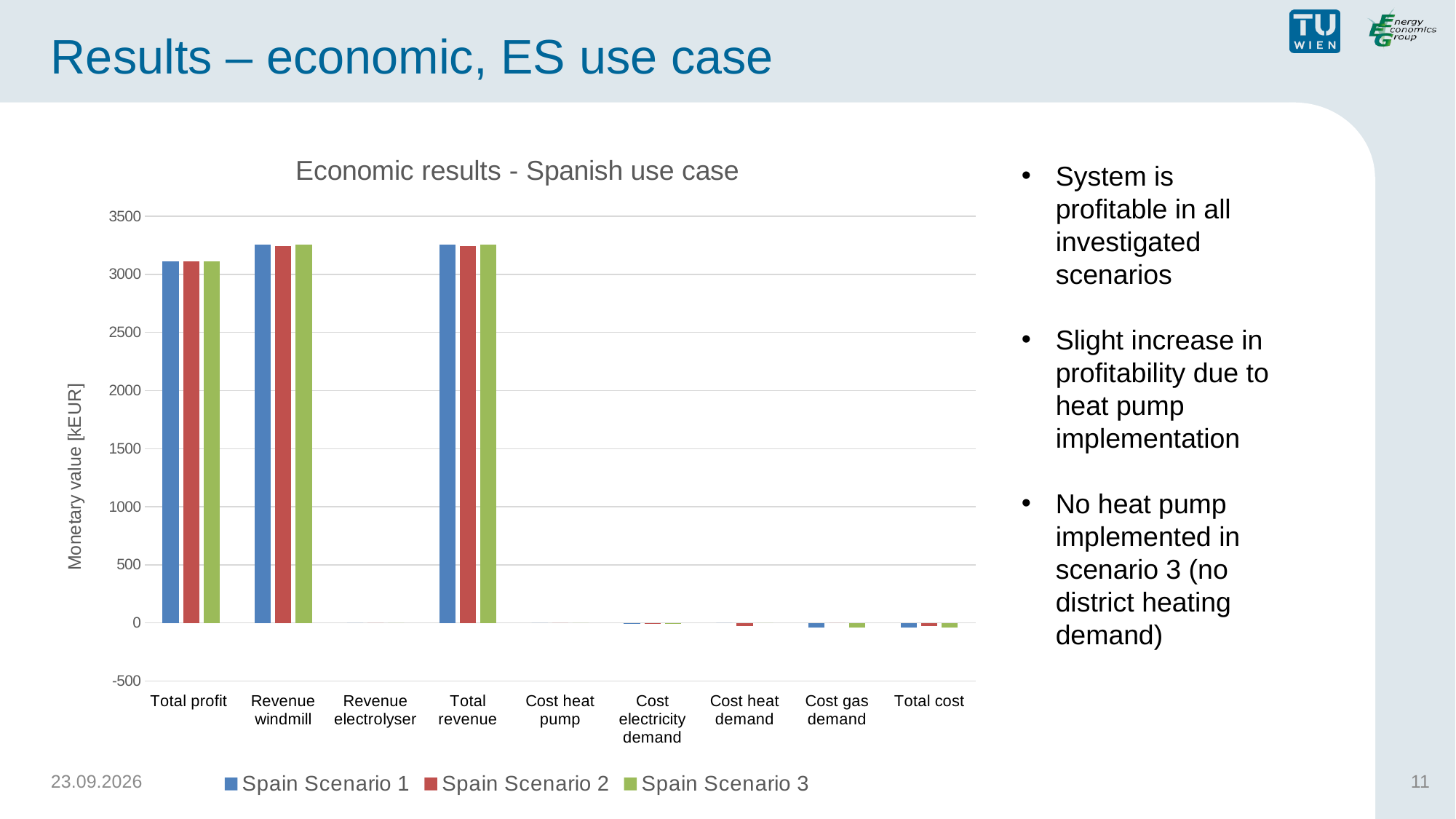
For Spain Scenario 1, which is larger: Total revenue or Total cost? Total revenue Is the value for Total profit in Spain Scenario 1 greater or less than 3000? greater How many categories are shown on the x axis? 9 For Spain Scenario 1, which is larger: Revenue windmill or Total profit? Revenue windmill For Spain Scenario 2, which is larger: Revenue windmill or Revenue electrolyser? Revenue windmill What is the title of the chart? Economic results - Spanish use case How many series does the legend list? 3 Is the value for Total revenue in Spain Scenario 3 greater or less than 2500? greater What is the label of the vertical axis? Monetary value [kEUR] Is the value for Revenue windmill in Spain Scenario 2 greater or less than 3500? less What kind of chart is shown on the slide? bar chart